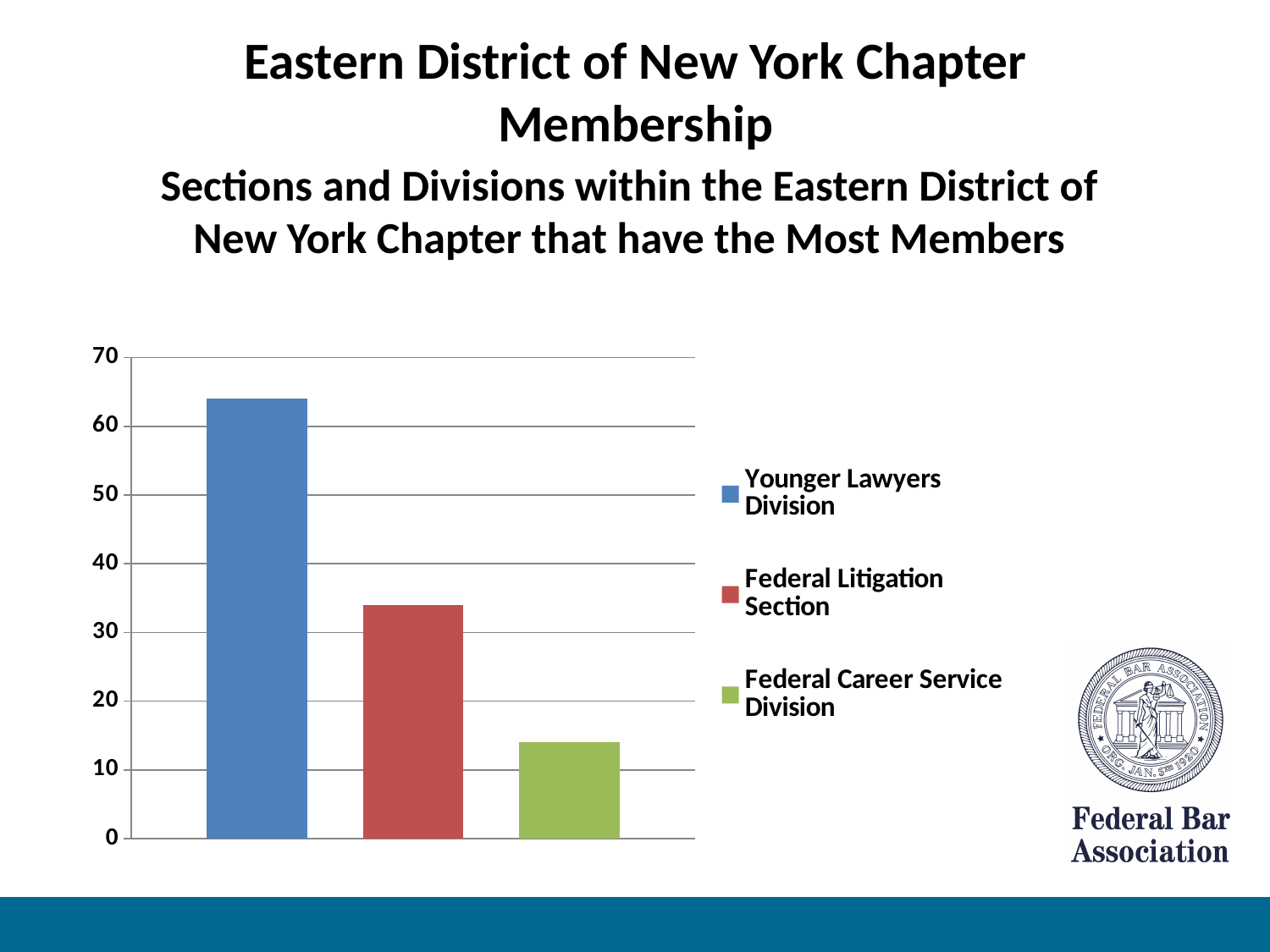
Is the value for Federal Career Service Division greater or less than 10? greater What is the highest value shown on the vertical axis? 70 Which is larger, the value for Federal Litigation Section or the value for Federal Career Service Division? Federal Litigation Section How many bars are plotted in the chart? 3 What colour is the bar for Federal Litigation Section? red Which is larger, the value for Younger Lawyers Division or the value for Federal Litigation Section? Younger Lawyers Division Is the value for Younger Lawyers Division greater or less than 60? greater What kind of chart is shown on the slide? bar chart How many series does the legend list? 3 Is the value for Federal Litigation Section greater or less than 40? less Which series has the lowest value? Federal Career Service Division Which series has the highest value? Younger Lawyers Division